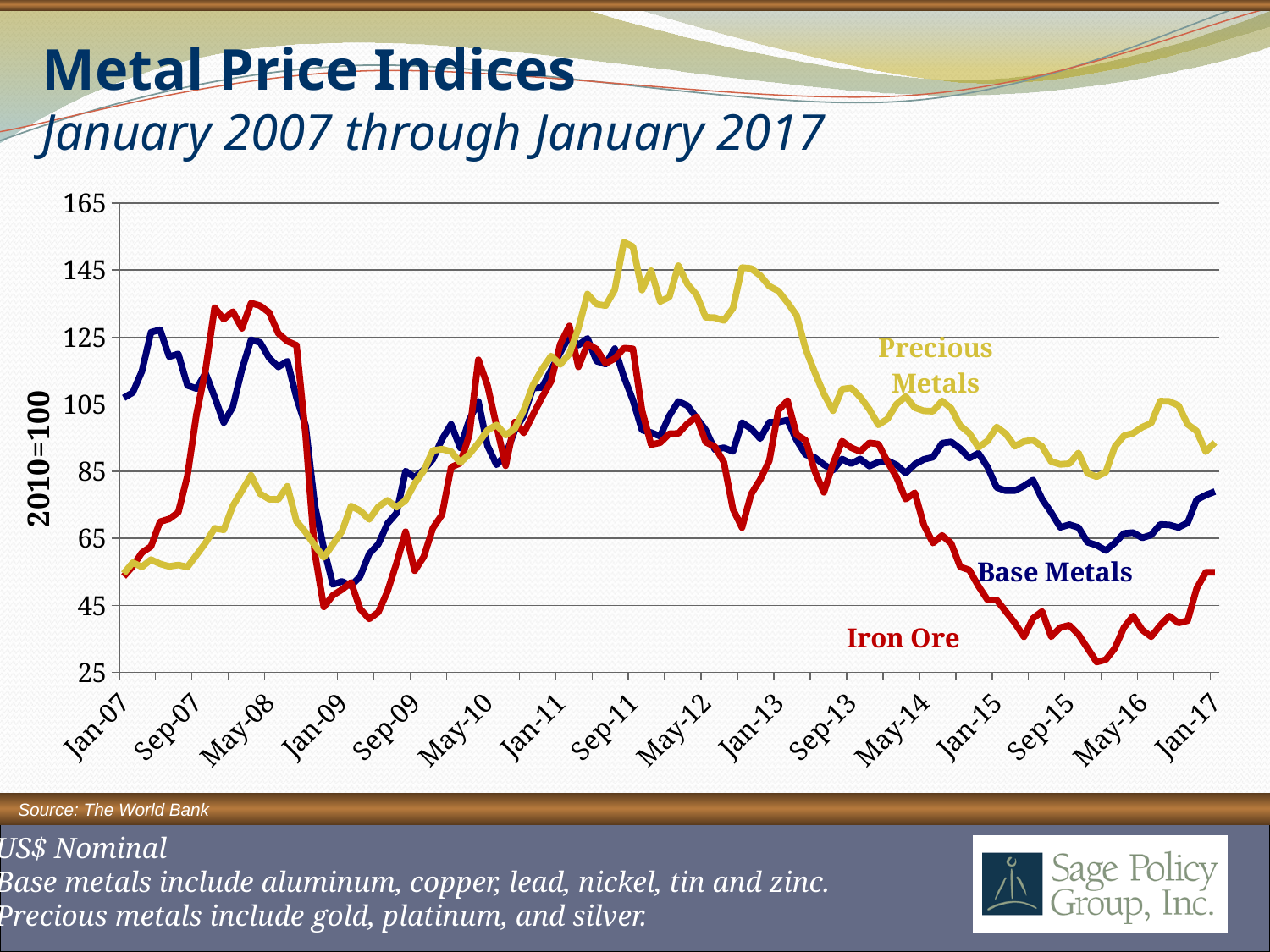
Is the lowest value of Iron Ore, reached around the end of 2015, greater or less than 45? less Which series has the highest value at Jan-17? Precious Metals How many series are plotted on the chart? 3 Is the value for Precious Metals at Jan-17 greater or less than 85? greater Is the value for Iron Ore at Jan-17 greater or less than 65? less Which series has the lowest value at Jan-17? Iron Ore What kind of chart is shown on the slide? Line chart Which series is plotted in red? Iron Ore Does the Iron Ore index rise or fall between Jan-13 and Jan-16? Fall What is the label on the vertical axis? 2010=100